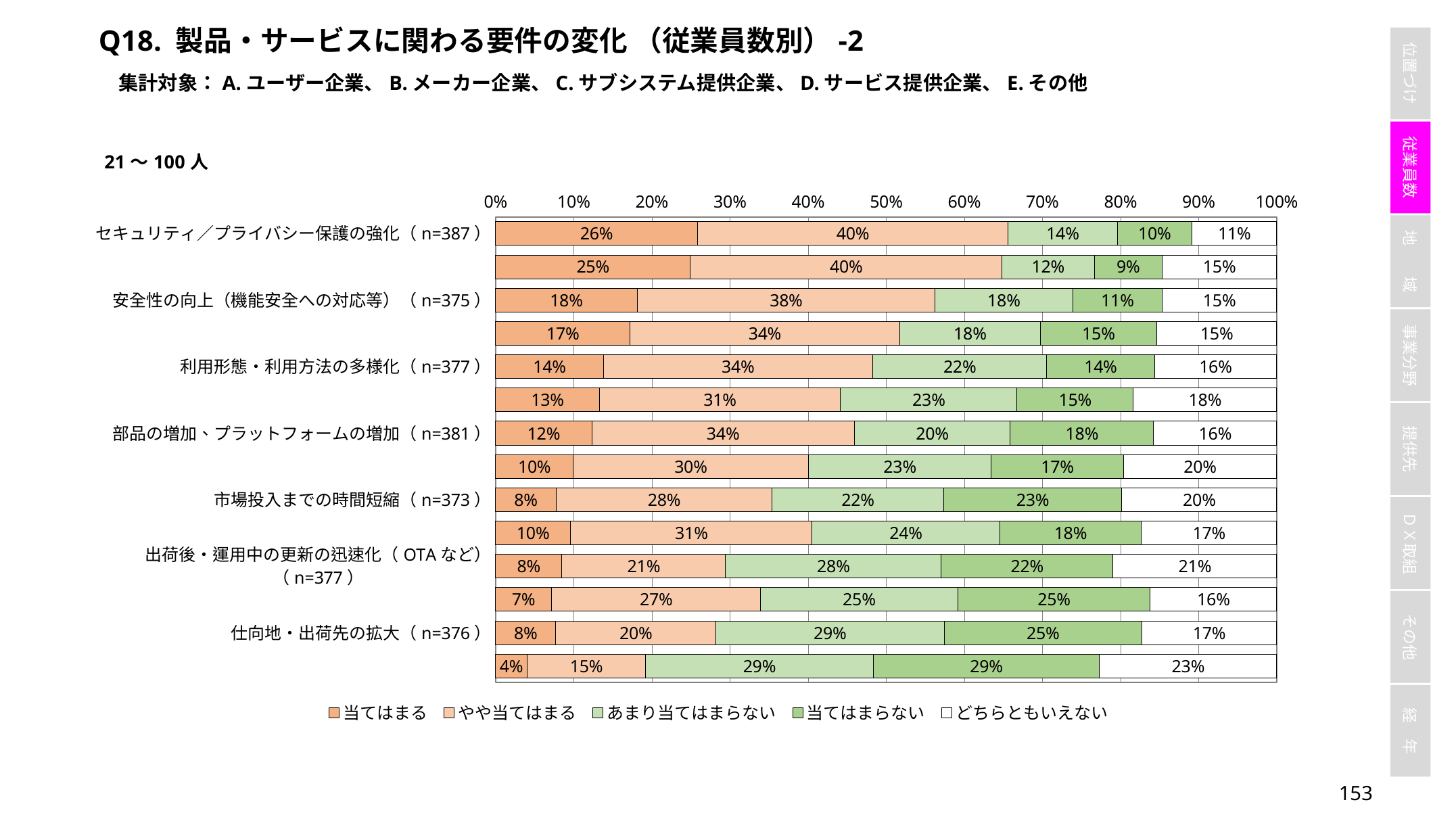
What is the first entry in the chart's legend? 当てはまる What is the 当てはまる value for the bar labeled セキュリティ／プライバシー保護の強化（n=387）? 26% Among the labeled bars, which category has the lowest やや当てはまる value? 仕向地・出荷先の拡大（n=376） How many labeled categories are shown on the chart's vertical axis? 7 What kind of chart is shown on the slide? Stacked bar chart What is the あまり当てはまらない value for the bar labeled 安全性の向上（機能安全への対応等）（n=375）? 18% Among the labeled bars, which category has the highest 当てはまる value? セキュリティ／プライバシー保護の強化（n=387） What is the 当てはまらない value for the bar labeled 仕向地・出荷先の拡大（n=376）? 25% What is the どちらともいえない value for the bar labeled 市場投入までの時間短縮（n=373）? 20% How many series does the legend list? 5 What is the difference between the 当てはまらない value for the bar labeled 仕向地・出荷先の拡大（n=376） and that for the bar labeled セキュリティ／プライバシー保護の強化（n=387）? 15 percentage points Which has the larger あまり当てはまらない value: the bar labeled 利用形態・利用方法の多様化（n=377） or the bar labeled 部品の増加、プラットフォームの増加（n=381）? 利用形態・利用方法の多様化（n=377）